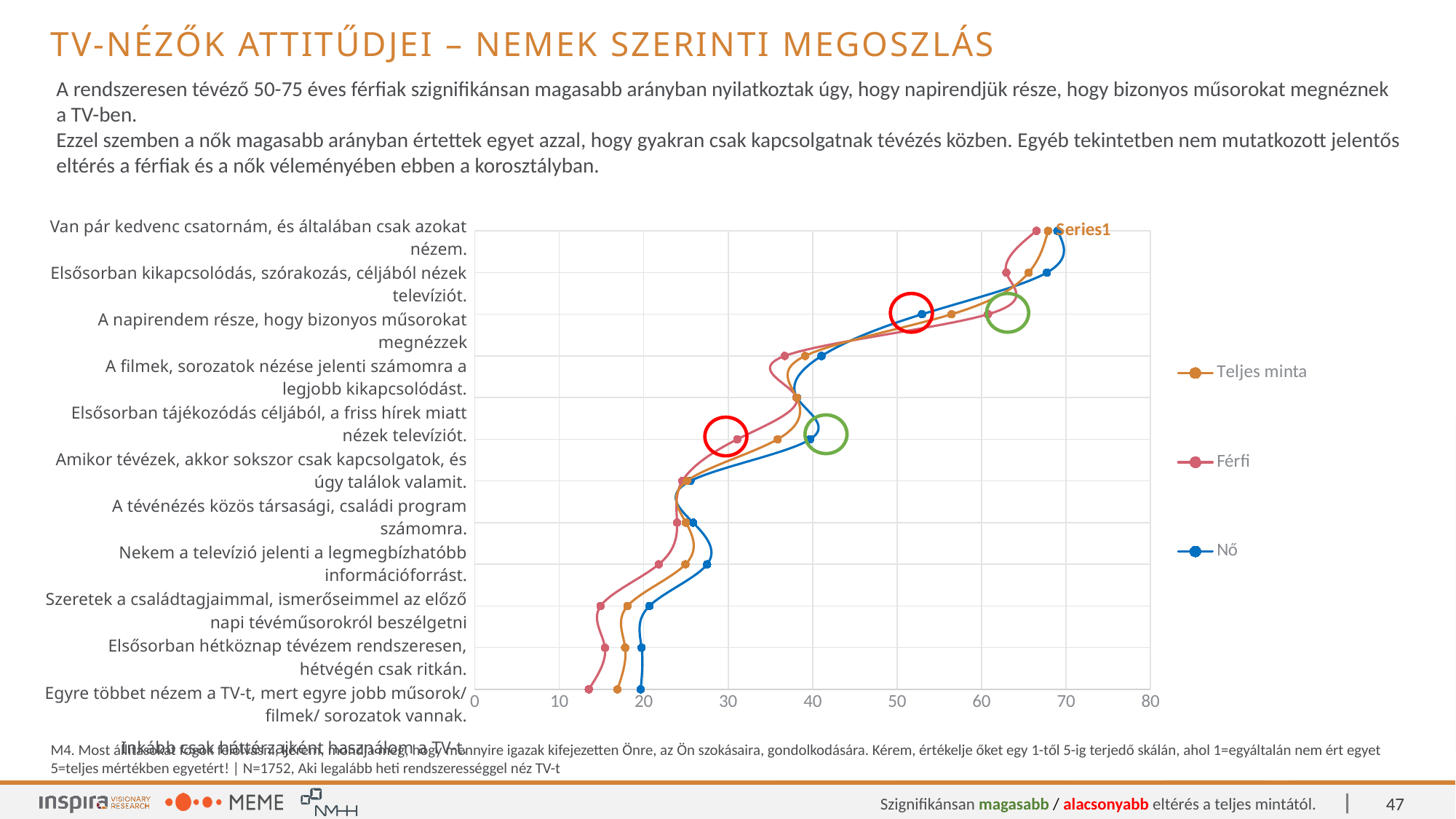
Is the Nő value for "Amikor tévézek, akkor sokszor csak kapcsolgatok, és úgy találok valamit." greater or less than 50? less For "Szeretek a családtagjaimmal, ismerőseimmel az előző napi tévéműsorokról beszélgetni", which series has the larger value, Férfi or Nő? Nő For "Amikor tévézek, akkor sokszor csak kapcsolgatok, és úgy találok valamit.", which series has the larger value, Férfi or Nő? Nő How many series does the chart legend list? 3 Which statement has the highest value for the Férfi series? Van pár kedvenc csatornám, és általában csak azokat nézem. Is the Teljes minta value for "Van pár kedvenc csatornám, és általában csak azokat nézem." greater or less than 60? greater What are the three series named in the chart legend? Teljes minta, Férfi, Nő Is the Férfi value for "Egyre többet nézem a TV-t, mert egyre jobb műsorok/ filmek/ sorozatok vannak." greater or less than 20? less For "A napirendem része, hogy bizonyos műsorokat megnézzek", which series has the larger value, Férfi or Nő? Férfi What colour is the line for the Nő series? blue What kind of chart is shown on the slide? line chart